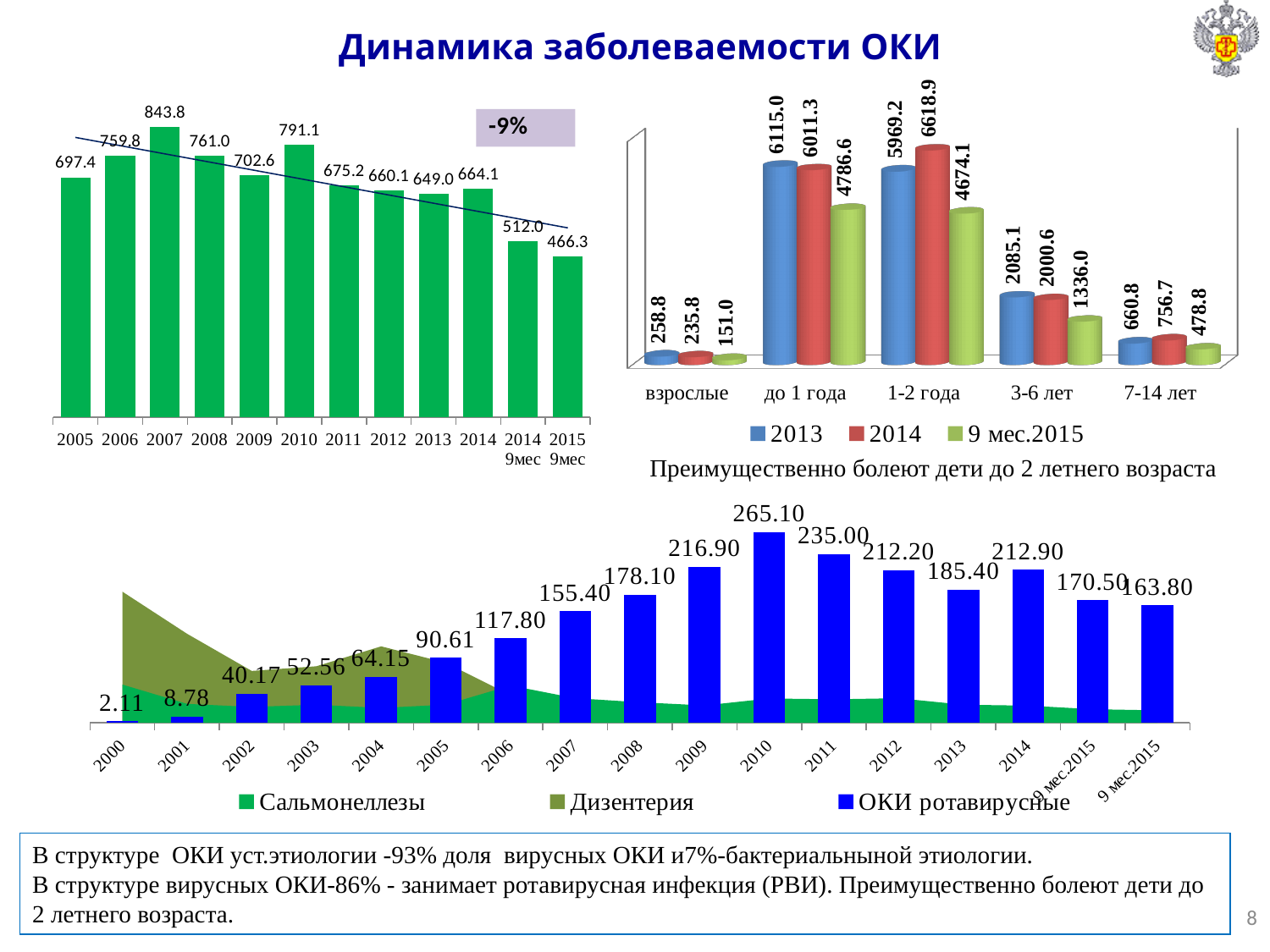
In the top-right chart, how many age-group categories are shown? 5 In the top-right chart, which is larger for the 7-14 лет group: the 2013 value or the 2014 value? 2014 In the bottom chart, what is the value for ОКИ ротавирусные in 2010? 265.10 In the top-left chart, which year has the highest value? 2007 In the bottom chart, which year has the highest value for ОКИ ротавирусные? 2010 In the top-left chart, what percentage change is shown in the box at the top right? -9% In the top-right chart, what is the 2014 value for the 1-2 года group? 6618.9 In the top-left chart, what is the value for 2007? 843.8 What kind of chart is the top-left chart? bar chart In the top-left chart, what is the difference between the 2014 9мес value and the 2015 9мес value? 45.7 In the top-right chart, which age group has the lowest 2013 value? взрослые In the top-right chart, how many series does the legend list? 3